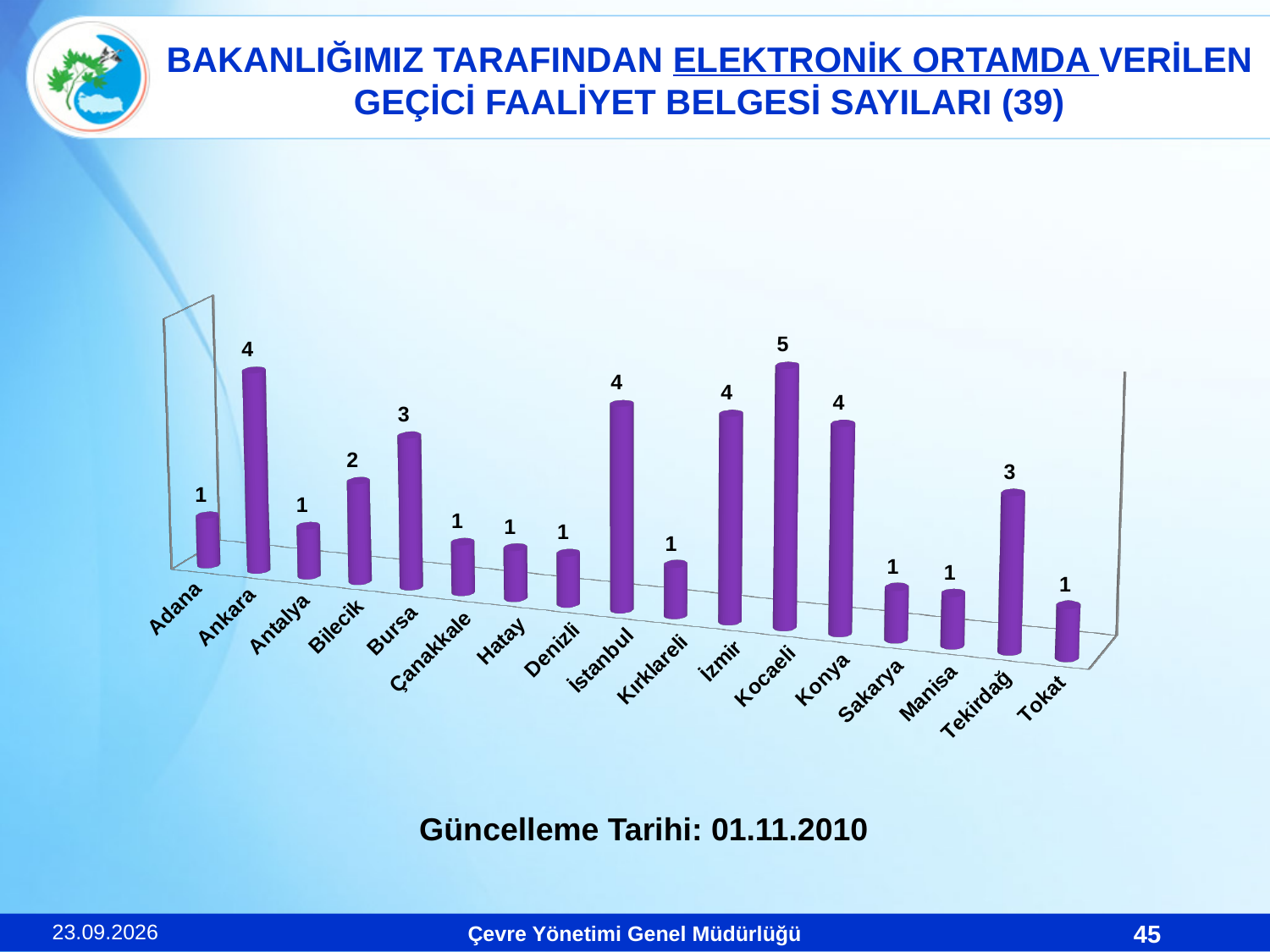
What is the value for Tekirdağ? 3 What is the difference between the values for Kocaeli and Bursa? 2 What is the difference between the values for Ankara and Adana? 3 What is the value for İstanbul? 4 Which is larger, the value for Konya or the value for Tekirdağ? Konya How many categories are shown on the x axis? 17 Which category has the highest value? Kocaeli What kind of chart is shown on the slide? Bar chart What is the value for Kocaeli? 5 What update date (Güncelleme Tarihi) is shown below the chart? 01.11.2010 What is the value for Bilecik? 2 What is the value for Bursa? 3